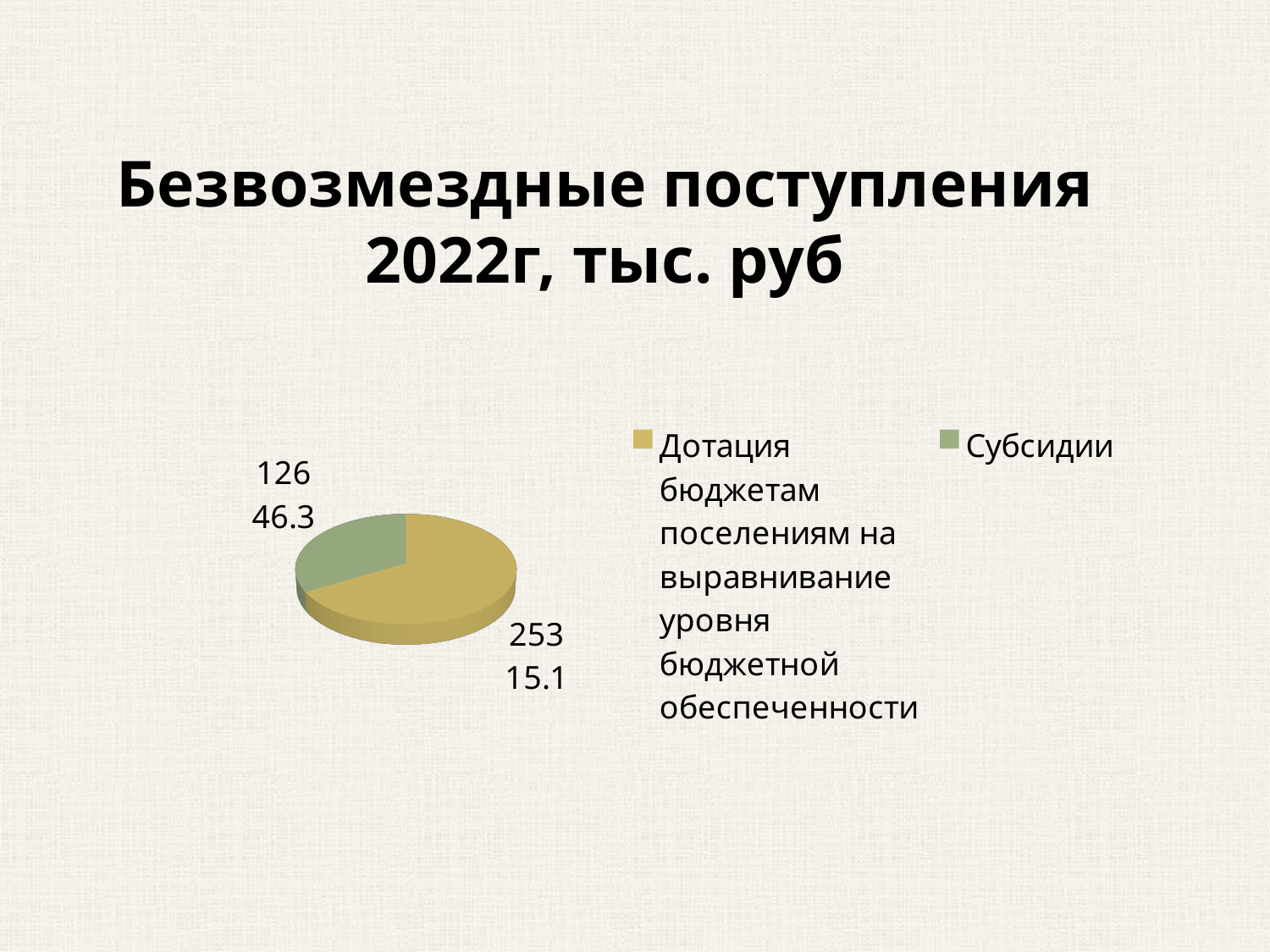
How many entries does the legend list? 2 What value is labelled on the slice for Дотация бюджетам поселениям на выравнивание уровня бюджетной обеспеченности? 25315.1 How many slices does the pie chart have? 2 What colour is the slice for Субсидии? green What is the difference between the value for Дотация бюджетам поселениям на выравнивание уровня бюджетной обеспеченности and the value for Субсидии? 12668.8 What value is labelled on the Субсидии slice? 12646.3 What is the title of the chart on the slide? Безвозмездные поступления 2022г, тыс. руб Which category has the largest slice of the pie? Дотация бюджетам поселениям на выравнивание уровня бюджетной обеспеченности Which is larger: the slice for Субсидии or the slice for Дотация бюджетам поселениям на выравнивание уровня бюджетной обеспеченности? Дотация бюджетам поселениям на выравнивание уровня бюджетной обеспеченности What is the total of the two values shown on the pie chart? 37961.4 What kind of chart is shown on the slide? pie chart Which category has the smallest slice of the pie? Субсидии